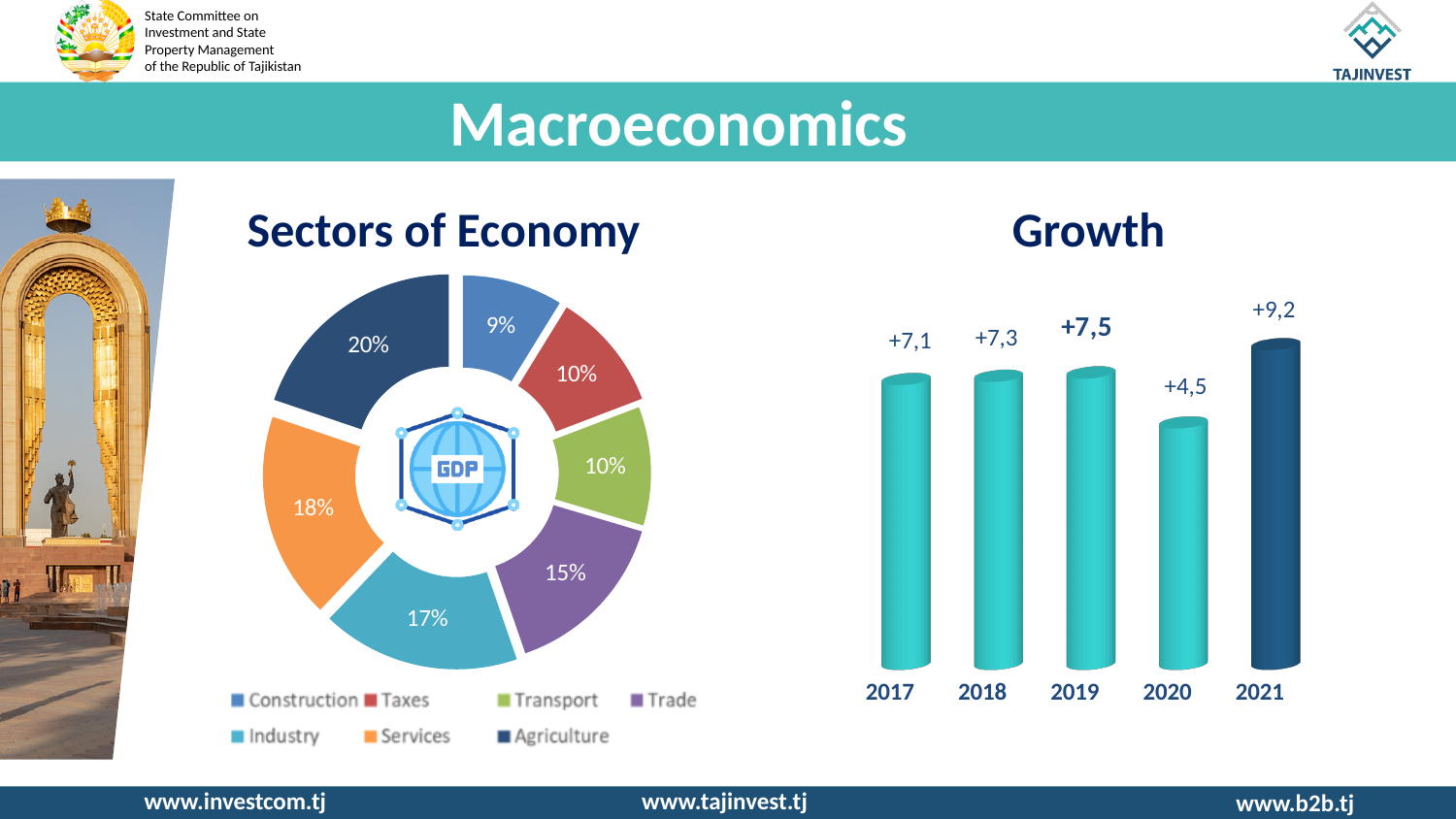
How many sectors does the legend of the Sectors of Economy chart list? 7 In the Sectors of Economy chart, which sector has the smallest share? Construction What kind of chart is the Growth chart? bar chart In the Sectors of Economy chart, what share does Agriculture have? 20% In the Growth chart, what is the value for 2021? +9,2 In the Growth chart, which year has the lowest value? 2020 In the Sectors of Economy chart, what share does Industry have? 17% In the Sectors of Economy chart, which is larger, Services or Trade? Services In the Growth chart, what is the value for 2020? +4,5 In the Growth chart, what is the difference between the values for 2021 and 2020? 4,7 In the Growth chart, which year has the highest value? 2021 In the Growth chart, how many years are shown? 5